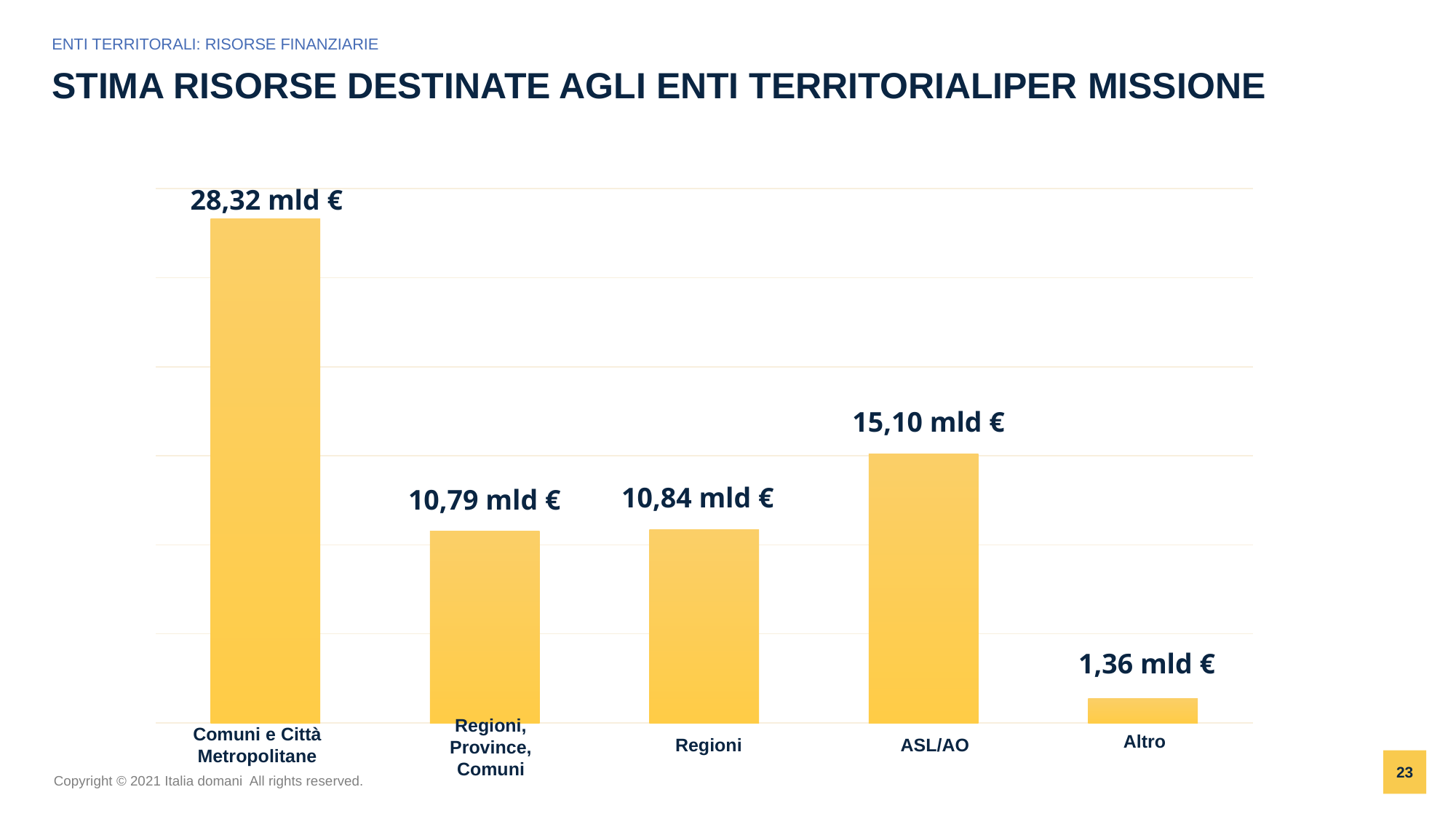
What is the value for ASL/AO? 15,10 mld € What is the value for Altro? 1,36 mld € Which category has the lowest value? Altro What is the value for Comuni e Città Metropolitane? 28,32 mld € What is the difference between ASL/AO and Regioni? 4,26 mld € Which is larger, Regioni or Regioni, Province, Comuni? Regioni What is the difference between Comuni e Città Metropolitane and ASL/AO? 13,22 mld € Which category has the highest value? Comuni e Città Metropolitane What is the value for Regioni? 10,84 mld € How many categories are shown in the chart? 5 What kind of chart is shown on the slide? Bar chart What is the title of the chart on the slide? STIMA RISORSE DESTINATE AGLI ENTI TERRITORIALIPER MISSIONE